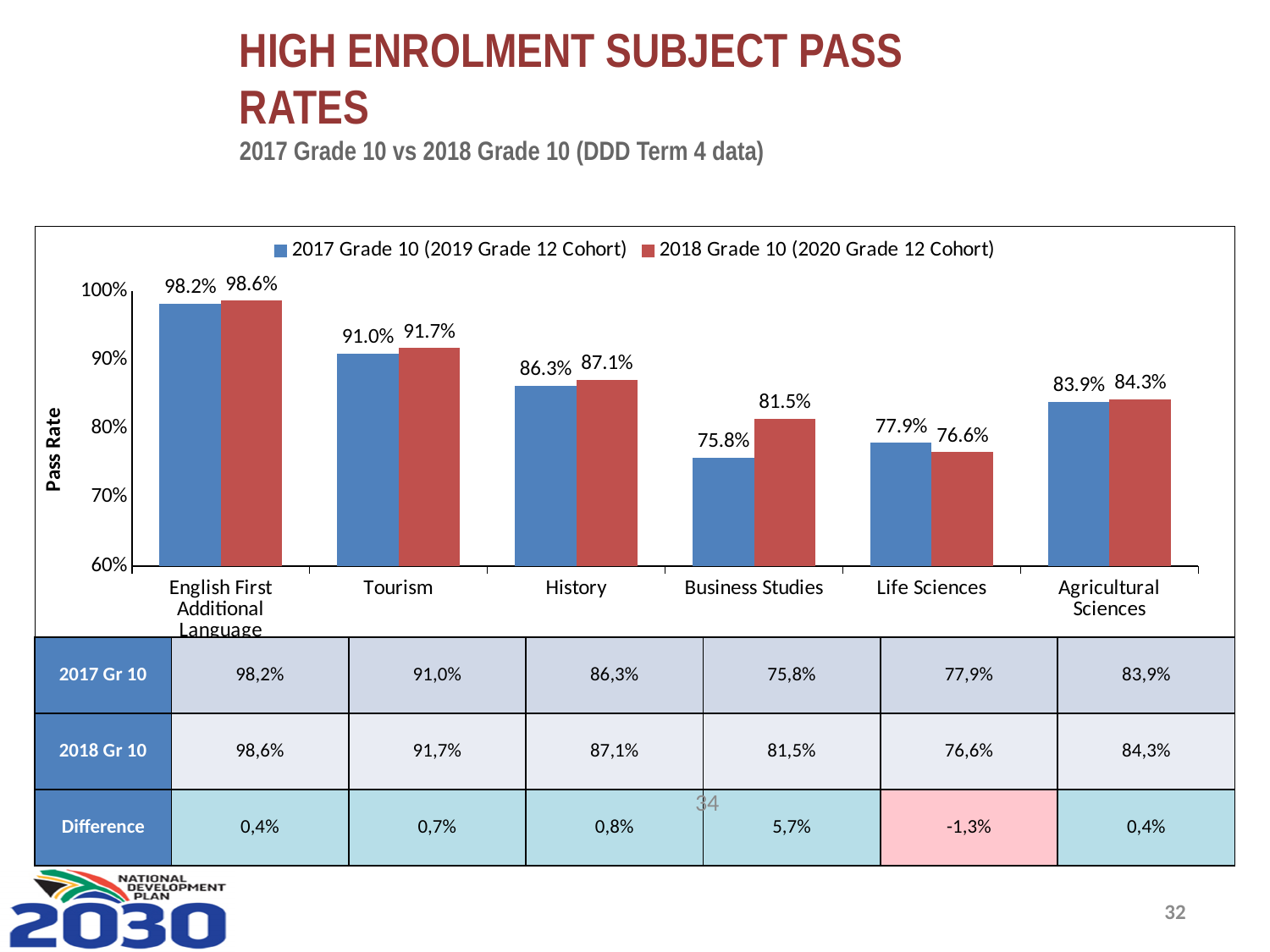
What is the pass rate for Tourism in the 2018 Grade 10 (2020 Grade 12 Cohort) series? 91.7% What is the pass rate for Life Sciences in the 2017 Grade 10 (2019 Grade 12 Cohort) series? 77.9% What kind of chart is shown on the slide? Bar chart Which subject has the highest pass rate in the 2017 Grade 10 (2019 Grade 12 Cohort) series? English First Additional Language What is the difference between the 2017 Grade 10 and 2018 Grade 10 pass rates for Life Sciences? 1.3% What is the pass rate for Business Studies in the 2018 Grade 10 (2020 Grade 12 Cohort) series? 81.5% How many series does the chart legend list? 2 What is the difference between the 2018 Grade 10 and 2017 Grade 10 pass rates for Business Studies? 5.7% How many subjects are shown on the x axis of the chart? 6 Which subject has the lowest pass rate in the 2018 Grade 10 (2020 Grade 12 Cohort) series? Life Sciences For Life Sciences, which series has the higher pass rate: 2017 Grade 10 or 2018 Grade 10? 2017 Grade 10 Which subject has the lowest pass rate in the 2017 Grade 10 (2019 Grade 12 Cohort) series? Business Studies